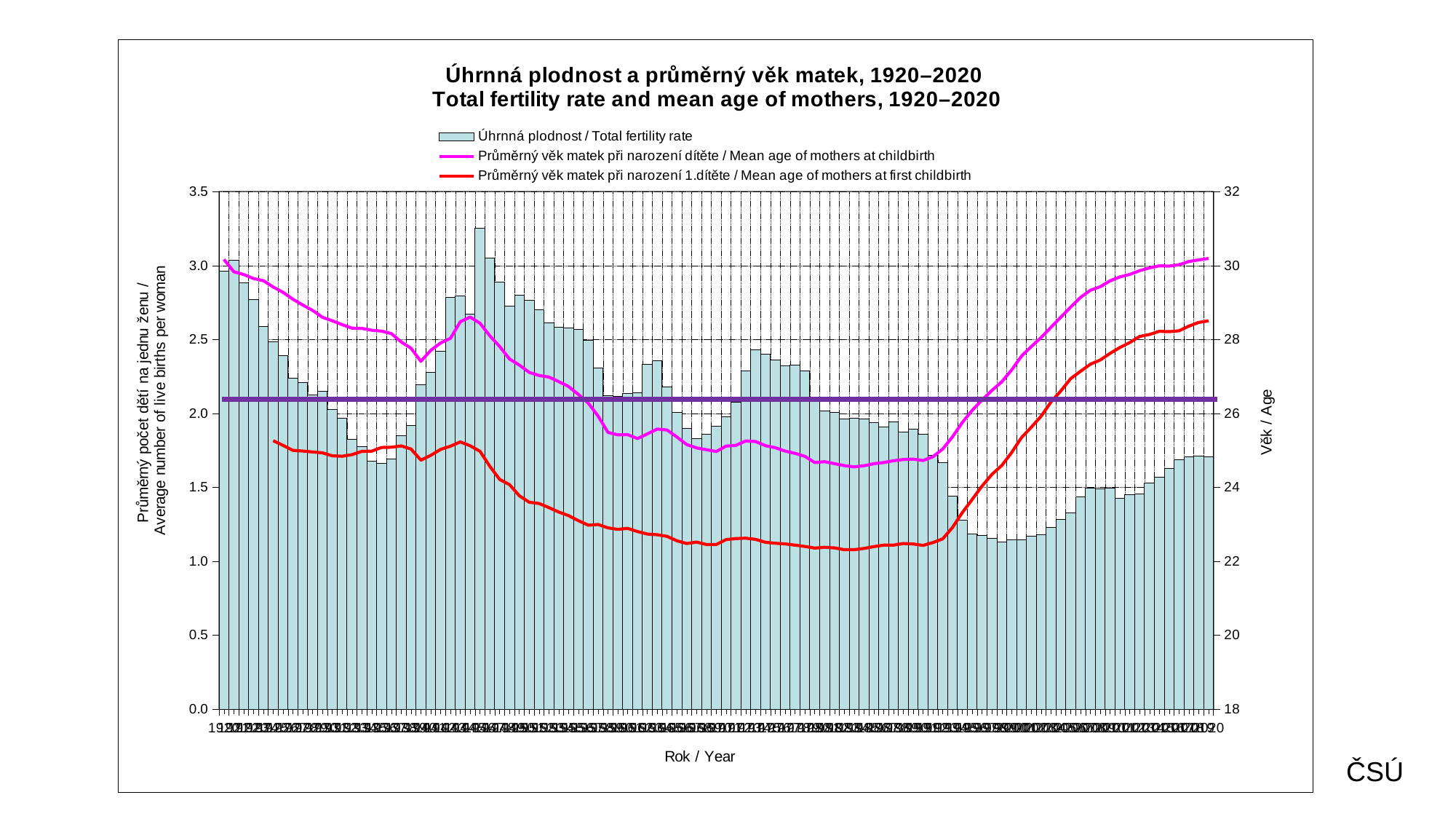
Which series is plotted as bars? Úhrnná plodnost / Total fertility rate How many series does the chart's legend list? 3 Is the total fertility rate for 2020 greater or less than 2.0? less Is the mean age of mothers at childbirth for 1920 greater or less than 28? greater Which year has the higher total fertility rate, 1920 or 2020? 1920 Is the mean age of mothers at first childbirth for 2020 greater or less than 30? less Does the total fertility rate rise or fall overall from 1920 to 2020? fall What kind of chart is this? A bar chart combined with line series What is the title of the chart? Úhrnná plodnost a průměrný věk matek, 1920–2020 / Total fertility rate and mean age of mothers, 1920–2020